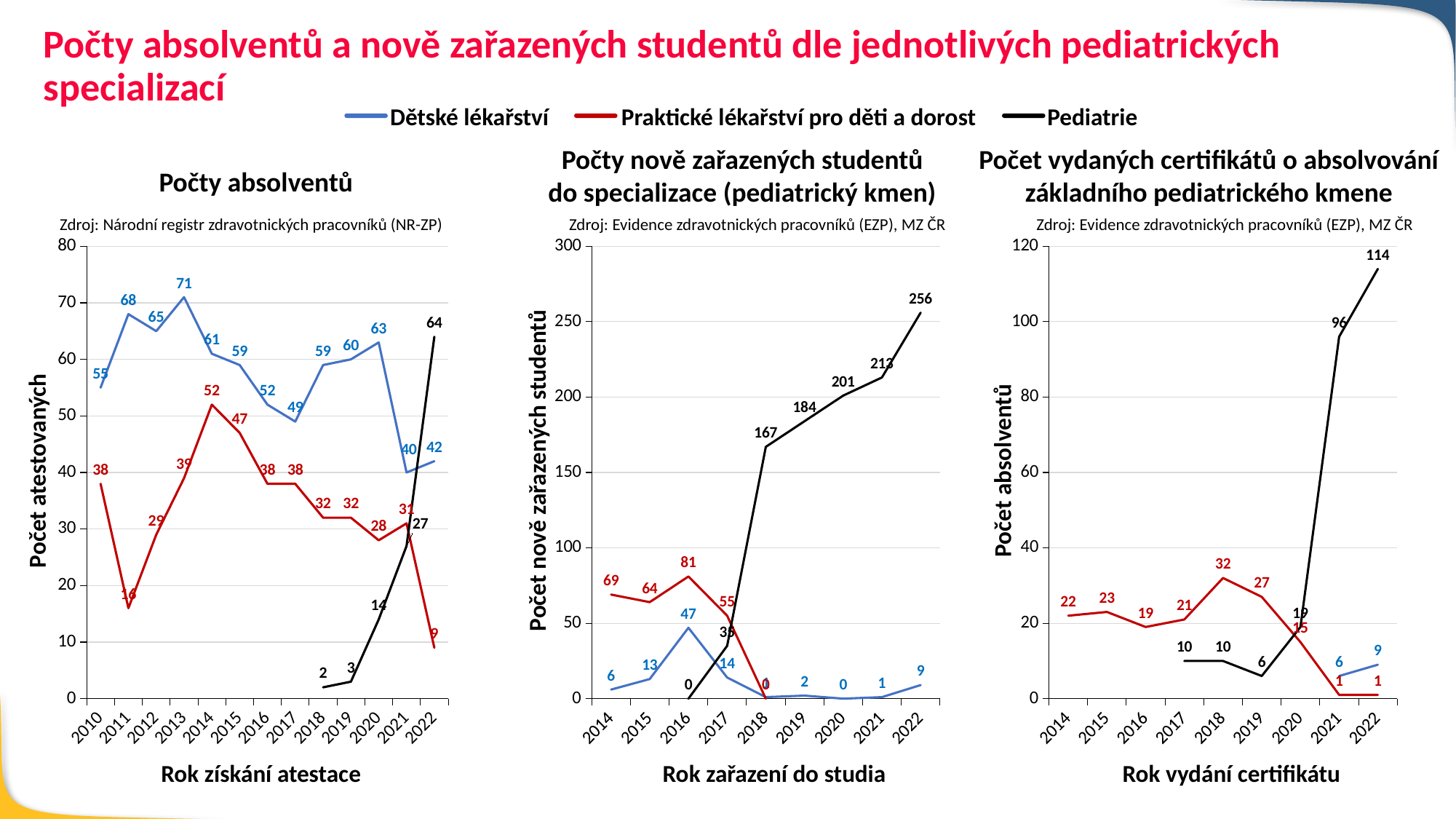
In the chart 'Počet vydaných certifikátů o absolvování základního pediatrického kmene', does the Pediatrie line rise or fall between 2019 and 2022? rise In the chart 'Počty absolventů', what is the difference between Dětské lékařství and Praktické lékařství pro děti a dorost in 2022? 33 In the chart 'Počet vydaných certifikátů o absolvování základního pediatrického kmene', which is larger in 2018: Praktické lékařství pro děti a dorost or Pediatrie? Praktické lékařství pro děti a dorost In the chart 'Počty nově zařazených studentů do specializace (pediatrický kmen)', how many years are shown on the x axis? 9 In the chart 'Počty absolventů', in which year does Dětské lékařství reach its highest value? 2013 In the chart 'Počty absolventů', what is the value for Dětské lékařství in 2013? 71 In the chart 'Počty nově zařazených studentů do specializace (pediatrický kmen)', in which year does Praktické lékařství pro děti a dorost reach its highest value? 2016 What kind of chart is 'Počty absolventů'? line chart In the chart 'Počty absolventů', what is the value for Pediatrie in 2022? 64 In the chart 'Počet vydaných certifikátů o absolvování základního pediatrického kmene', what is the value for Pediatrie in 2021? 96 How many series does the shared legend list? 3 In the chart 'Počty nově zařazených studentů do specializace (pediatrický kmen)', what is the value for Pediatrie in 2022? 256